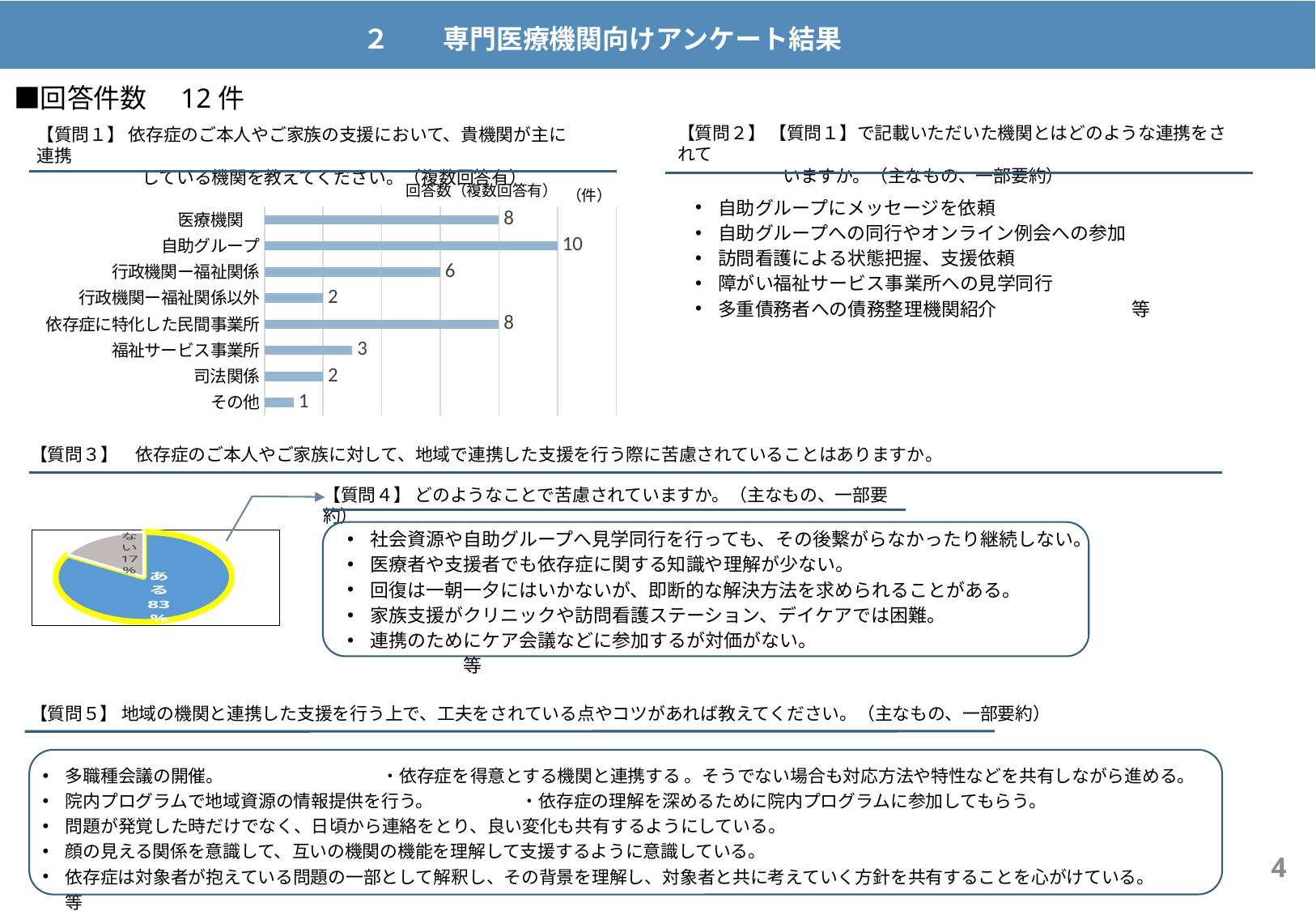
What kind of chart is shown under 質問3 on the left of the slide? pie chart In the bar chart titled 回答数（複数回答有）, what is the value for 福祉サービス事業所? 3 How many categories are shown in the bar chart titled 回答数（複数回答有）? 8 In the bar chart titled 回答数（複数回答有）, which category has the lowest value? その他 In the bar chart titled 回答数（複数回答有）, what is the value for 行政機関－福祉関係? 6 What kind of chart is the chart titled 回答数（複数回答有）? bar chart In the bar chart titled 回答数（複数回答有）, what is the value for 自助グループ? 10 In the pie chart under 質問3, what share of responses is ある? 83% In the bar chart titled 回答数（複数回答有）, which is larger, the value for 行政機関－福祉関係 or the value for 福祉サービス事業所? 行政機関－福祉関係 In the bar chart titled 回答数（複数回答有）, which category has the highest value? 自助グループ In the bar chart titled 回答数（複数回答有）, what is the difference between the values for 自助グループ and 医療機関? 2 In the pie chart under 質問3, what share of responses is ない? 17%